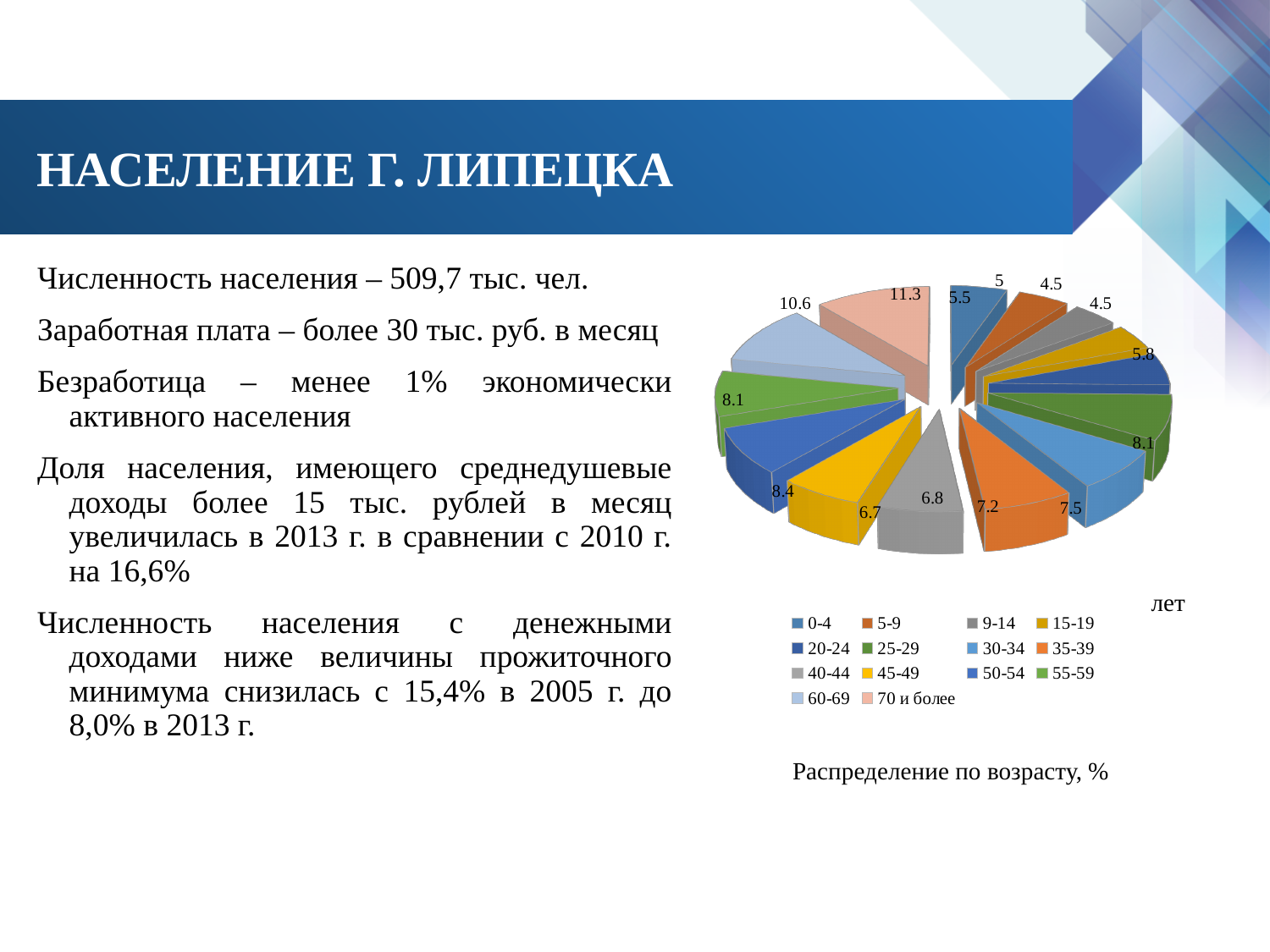
How many age categories does the pie chart's legend list? 14 What is the difference between the values for the 50-54 and 20-24 age groups? 2.6 What is the value for the 70 и более age group in the pie chart? 11.3 What kind of chart is shown on the slide? pie chart Which is larger in the pie chart: the value for 30-34 or the value for 45-49? 30-34 Which age group has the largest slice in the pie chart? 70 и более What is the value for the 40-44 age group in the pie chart? 6.8 What is the value for the 60-69 age group in the pie chart? 10.6 What is the value for the 50-54 age group in the pie chart? 8.4 What is the caption printed below the pie chart? Распределение по возрасту, % What is the difference between the values for the 70 и более and 60-69 age groups? 0.7 What is the value for the 0-4 age group in the pie chart? 5.5